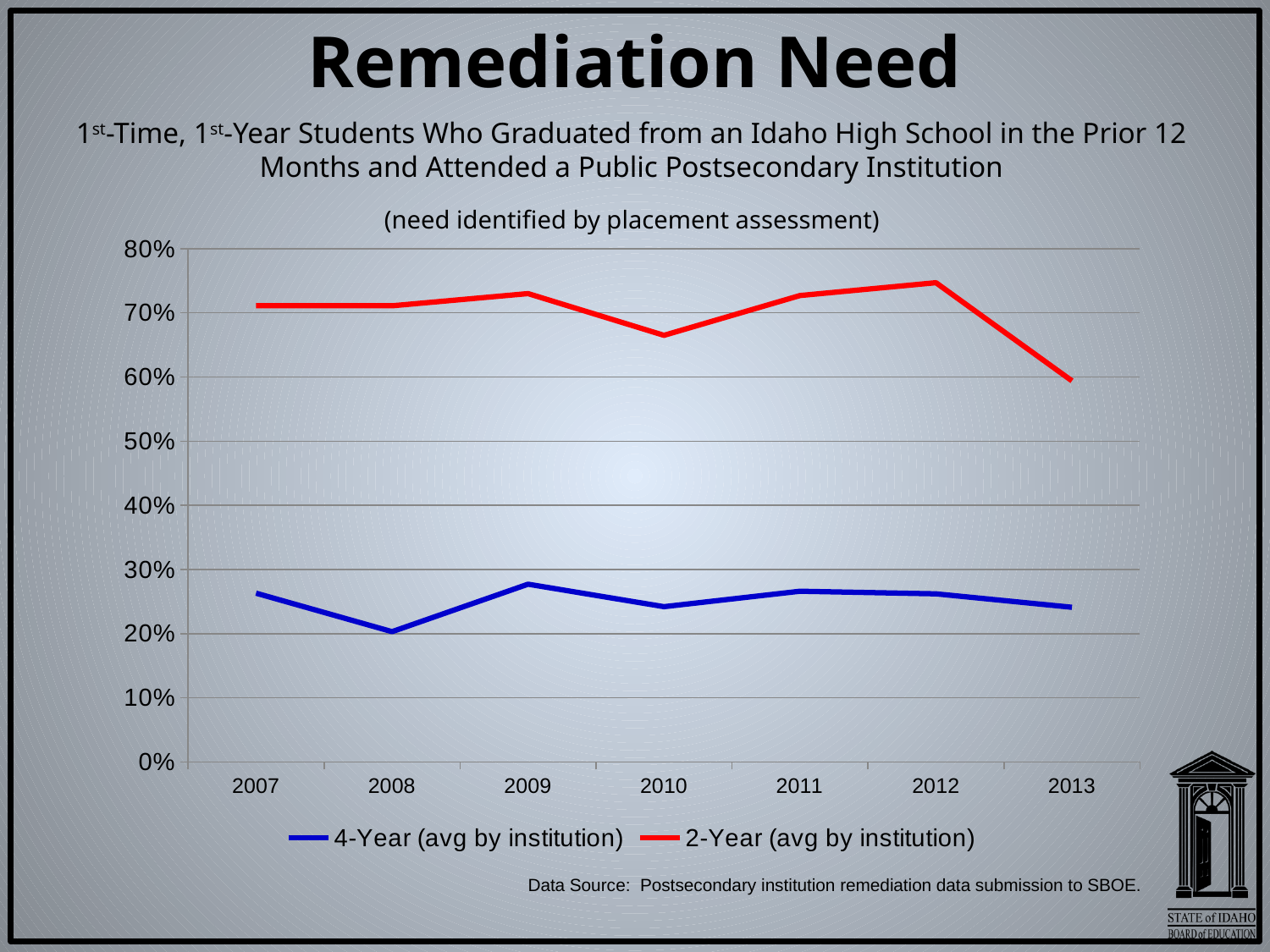
Is the value for 4-Year (avg by institution) in 2009 greater or less than 30%? less How many years are plotted along the x axis? 7 Which colour is used for the 4-Year (avg by institution) line? Blue In which year is the 4-Year (avg by institution) series at its lowest? 2008 In which year is the 2-Year (avg by institution) series at its highest? 2012 What kind of chart is shown on the slide? Line chart Is the value for 2-Year (avg by institution) in 2010 greater or less than 70%? less Which is larger: the 2-Year (avg by institution) value in 2012 or in 2013? 2012 Does the 2-Year (avg by institution) series rise or fall from 2012 to 2013? Fall How many series does the legend list? 2 Is the value for 2-Year (avg by institution) in 2012 greater or less than 70%? greater In which year is the 2-Year (avg by institution) series at its lowest? 2013